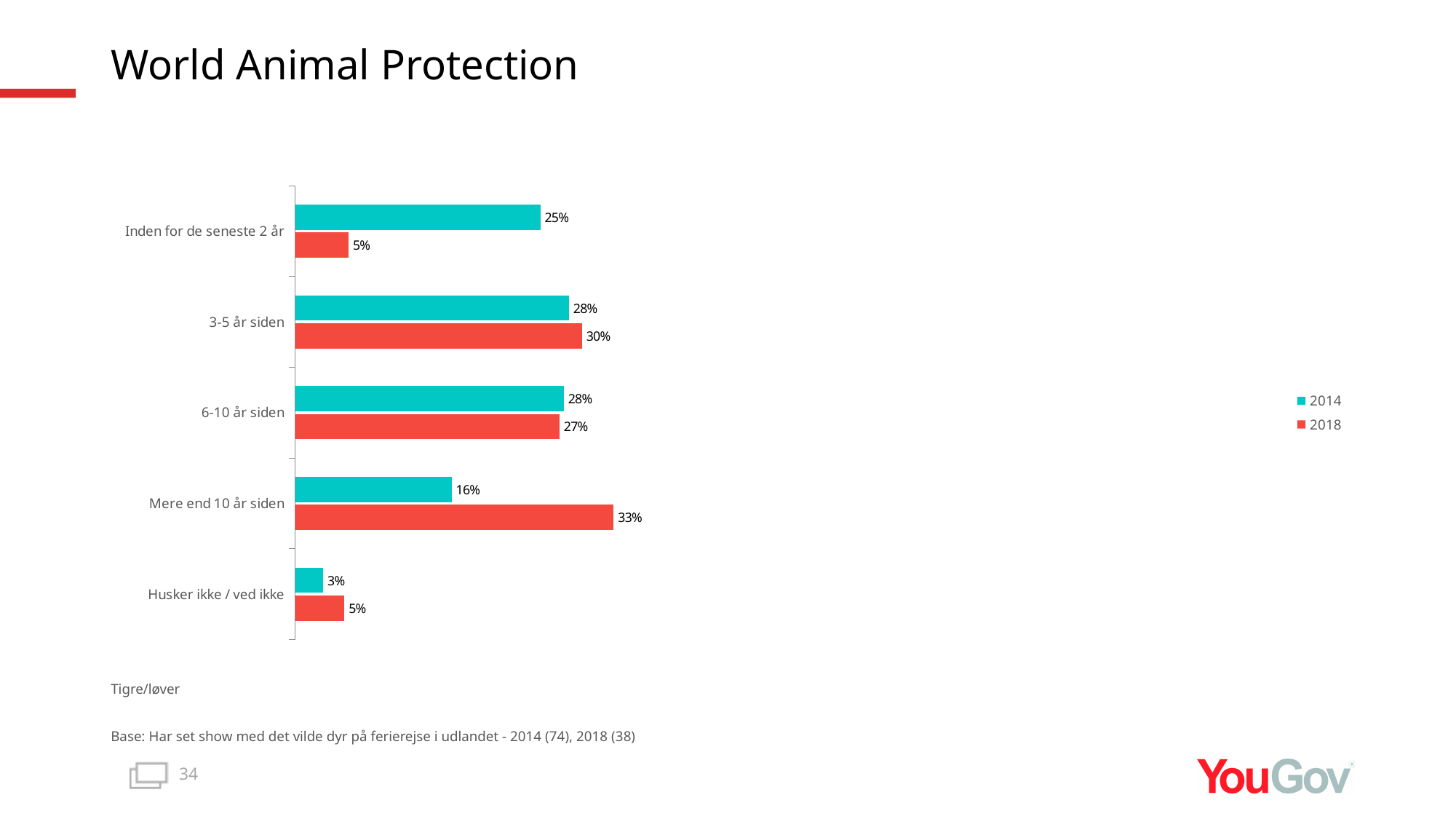
What is the 2018 value for "Mere end 10 år siden"? 33% Which category has the highest 2018 value? Mere end 10 år siden For "6-10 år siden", which year has the larger value, 2014 or 2018? 2014 What is the 2018 value for "3-5 år siden"? 30% Which colour represents the 2018 series? Red What is the 2014 value for "Inden for de seneste 2 år"? 25% What is the difference between the 2014 and 2018 values for "Inden for de seneste 2 år"? 20 percentage points What kind of chart is shown on the slide? Bar chart How many series does the legend list? 2 What is the difference between the 2018 and 2014 values for "Mere end 10 år siden"? 17 percentage points How many categories are shown on the chart? 5 Which category has the lowest 2014 value? Husker ikke / ved ikke